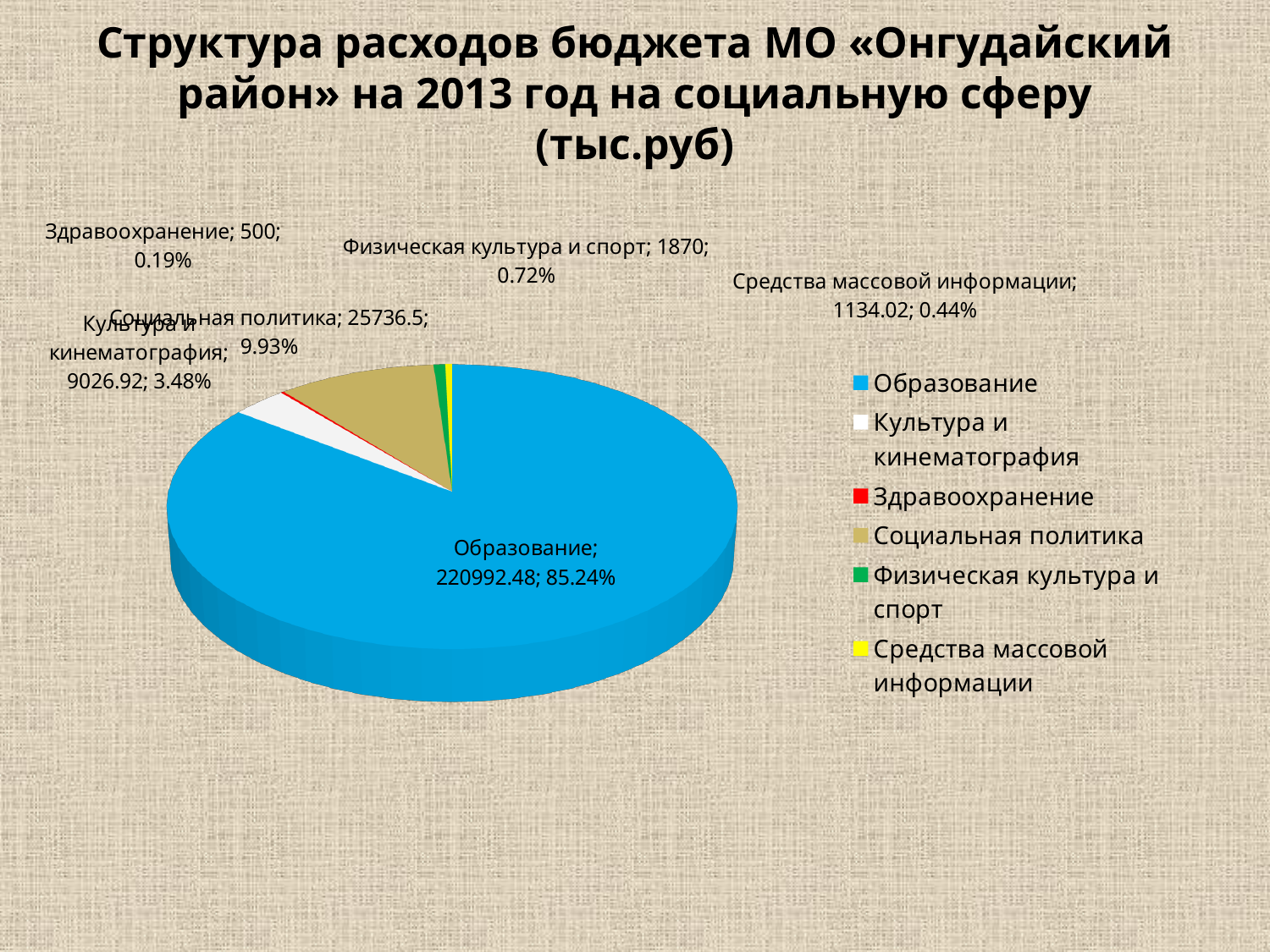
What is the value for Образование? 220992.48 What is the value for Здравоохранение? 500 What kind of chart is shown on the slide? Pie chart How many categories does the legend list? 6 Which category has the smallest slice of the pie? Здравоохранение What is the value for Социальная политика? 25736.5 Which is larger, Физическая культура и спорт or Средства массовой информации? Физическая культура и спорт What share of the pie does Физическая культура и спорт take? 0.72% What share of the pie does Образование take? 85.24% What is the value for Культура и кинематография? 9026.92 What is the value for Средства массовой информации? 1134.02 What share of the pie does Социальная политика take? 9.93%